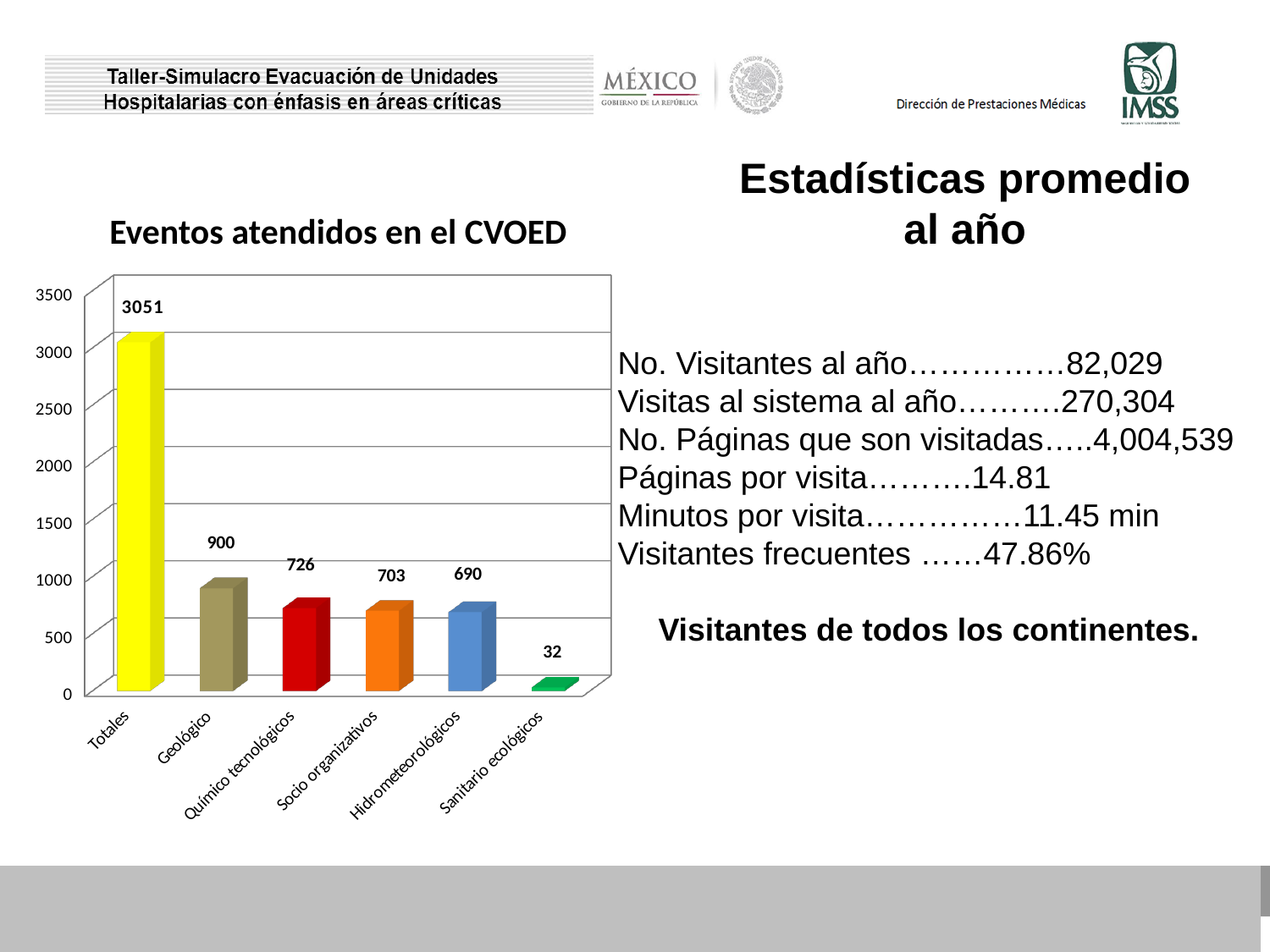
What kind of chart is shown on the slide? bar chart Is the value for Totales greater or less than 3000? greater Which category has the lowest value in the chart? Sanitario ecológicos How many categories are shown in the chart? 6 What is the value for Sanitario ecológicos in the chart? 32 Which category has the highest value in the chart? Totales What is the value for Geológico in the chart? 900 What is the title of the chart? Eventos atendidos en el CVOED What is the difference between the values for Geológico and Químico tecnológicos? 174 What colour is the bar for Totales? yellow Which is larger, the value for Socio organizativos or the value for Hidrometeorológicos? Socio organizativos What is the value for Hidrometeorológicos in the chart? 690